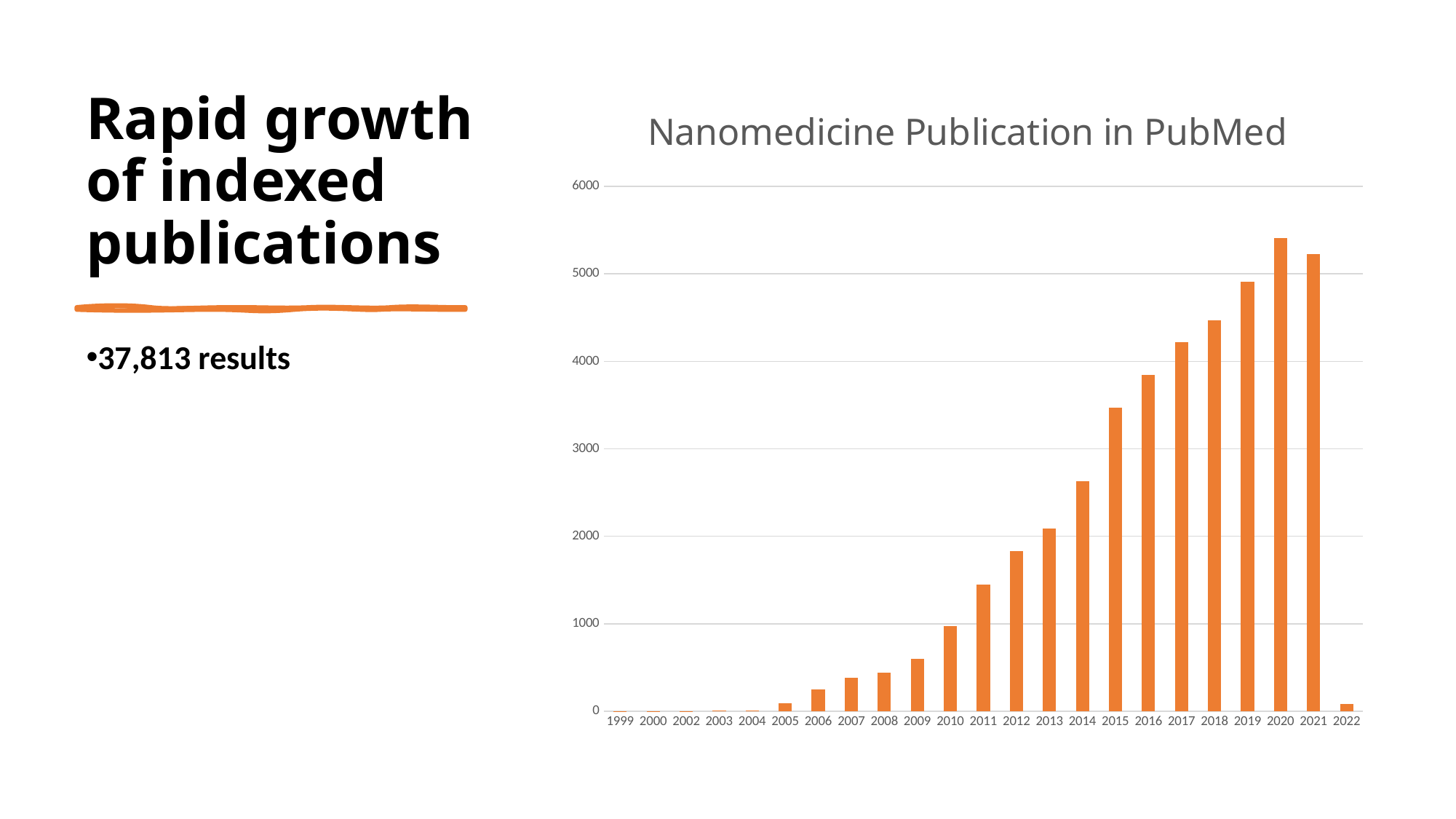
Which year has the highest number of publications in the chart? 2020 Is the value for 2015 greater or less than 3000? greater What kind of chart is shown on the slide? bar chart Is the value for 2022 greater or less than 1000? less Is the value for 2012 greater or less than 2000? less What is the title of the chart? Nanomedicine Publication in PubMed Which year has the larger value, 2020 or 2021? 2020 Which year has the larger value, 2014 or 2016? 2016 Do the values generally rise or fall from 2005 to 2020? rise